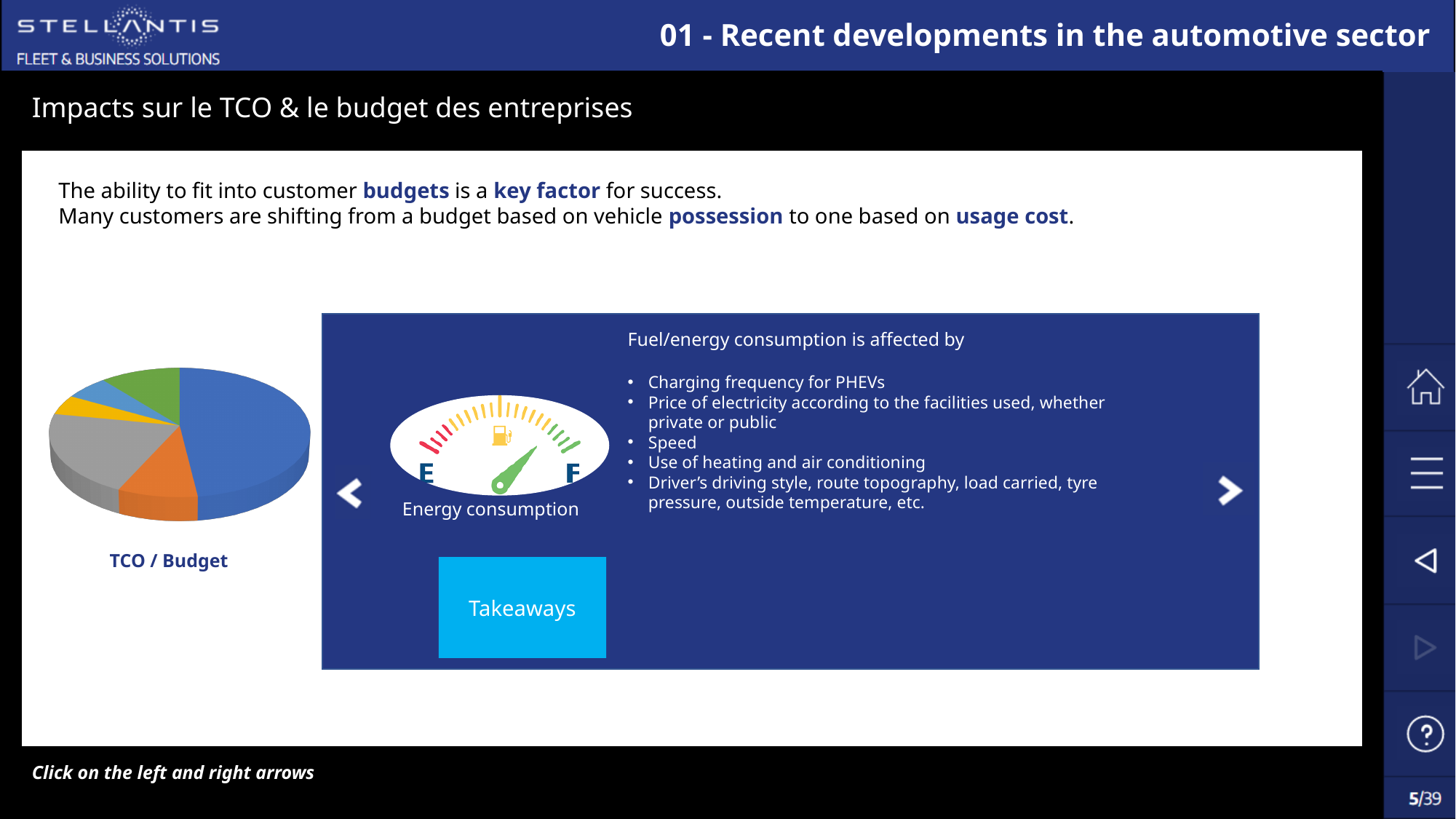
How many slices does the TCO / Budget pie chart have? 6 In the TCO / Budget pie chart, which slice is larger, the blue one or the orange one? blue In the TCO / Budget pie chart, which slice is larger, the gray one or the yellow one? gray Which colour slice is the largest in the TCO / Budget pie chart? blue Does the TCO / Budget pie chart display a legend? No What is the label shown beneath the pie chart? TCO / Budget What kind of chart is shown under the label "TCO / Budget"? pie chart